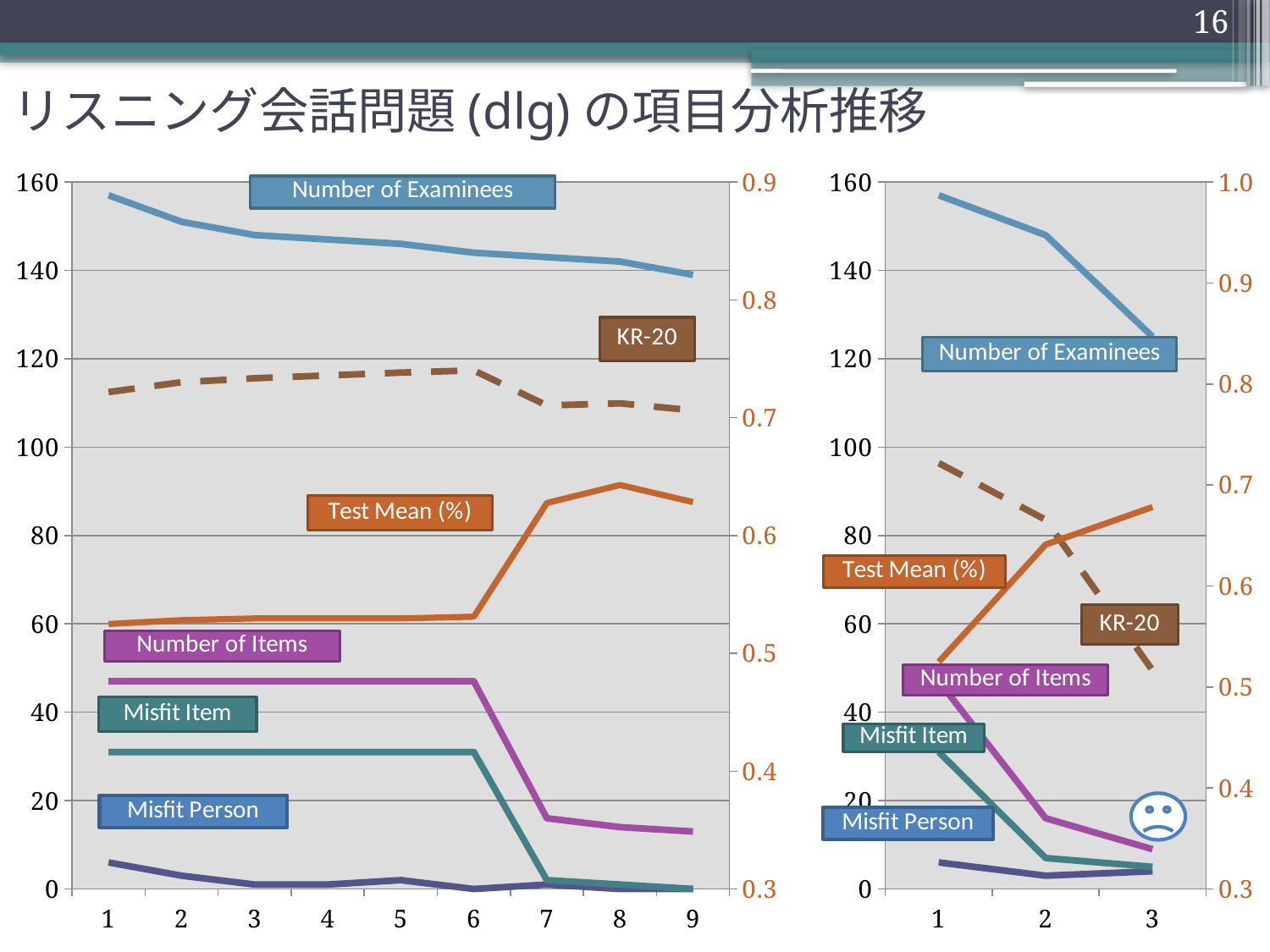
In the left chart, which series is drawn with a dashed line? KR-20 In the left chart, how many points are plotted along the x axis for each series? 9 In the right chart, does the Test Mean (%) line rise or fall from point 1 to point 3? rise In the right chart, how many points are plotted along the x axis for each series? 3 In the left chart, is the value for Misfit Item at point 6 greater or less than 20? greater In the right chart, does the KR-20 line rise or fall from point 1 to point 3? fall In the left chart, is the value for Number of Examinees at point 1 greater or less than 140? greater In the left chart, is the value for Number of Items at point 9 greater or less than 20? less What kind of chart is the left chart on the slide? line chart In the left chart, which is higher at point 1, Number of Items or Misfit Item? Number of Items In the left chart, does the Number of Examinees line rise or fall from point 1 to point 9? fall